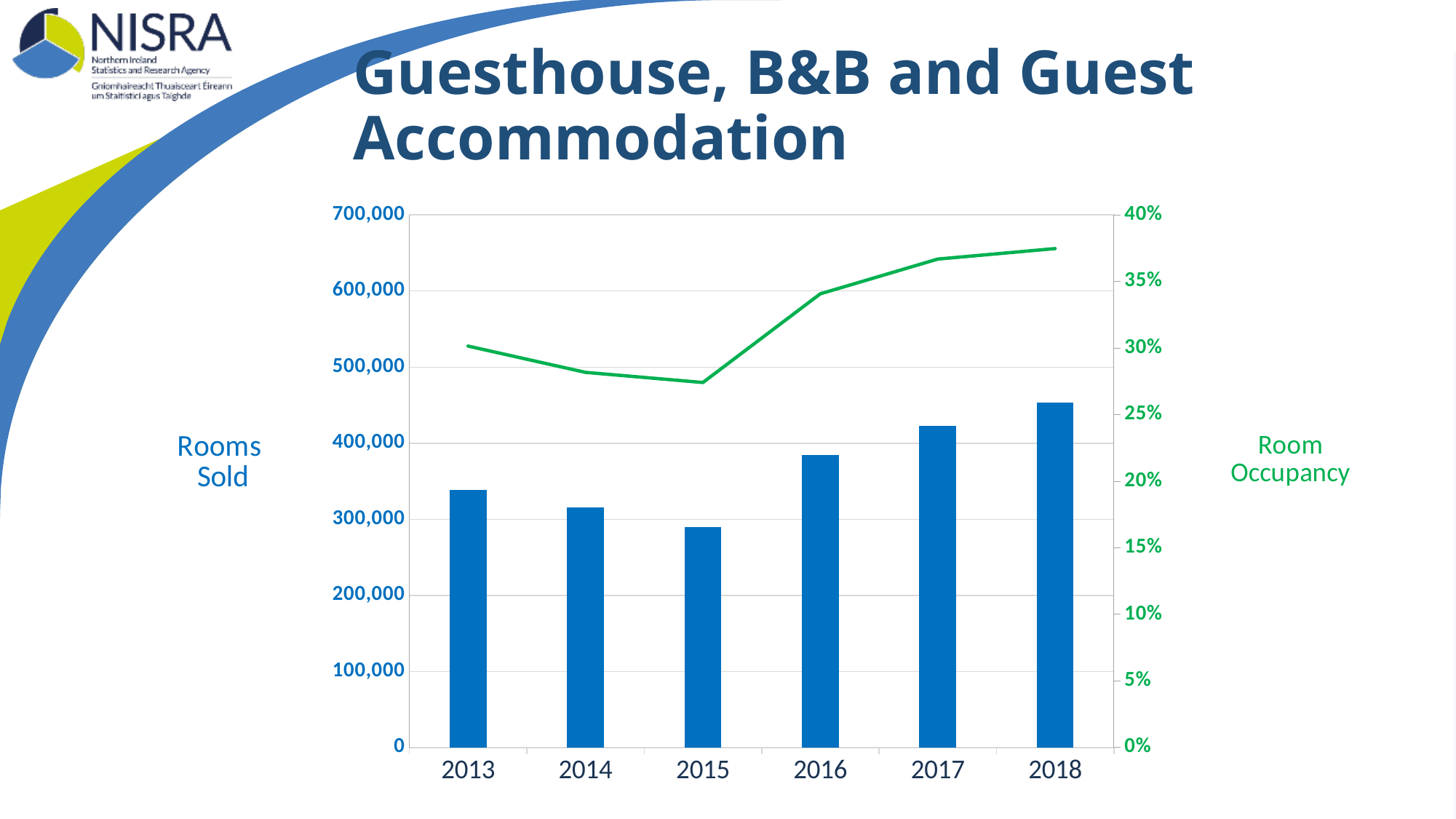
Which year has the lowest number of rooms sold? 2015 How many years are shown on the x axis of the chart? 6 Is the room occupancy for 2014 greater or less than 30%? less Is the value for rooms sold in 2018 greater or less than 400,000? greater Is the value for rooms sold in 2015 greater or less than 300,000? less Which year had more rooms sold, 2013 or 2014? 2013 Do rooms sold rise or fall from 2015 to 2018? rise Which year has the highest number of rooms sold? 2018 What does the right-hand axis of the chart measure? Room Occupancy Does room occupancy rise or fall from 2013 to 2015? fall What kind of chart is shown on the slide? A bar chart combined with a line chart